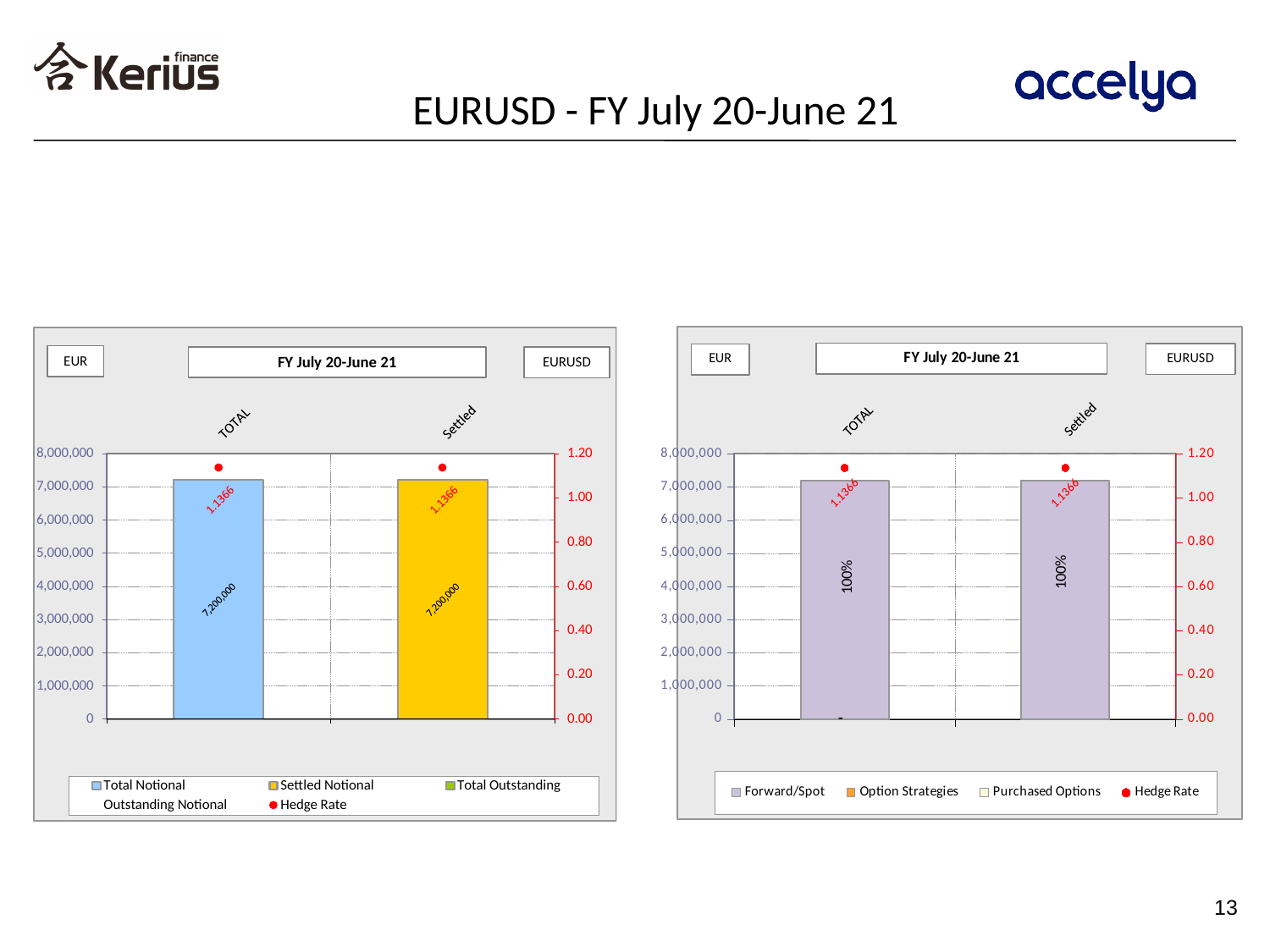
In the right chart, is the Hedge Rate for TOTAL greater or less than 1.00? greater In the right chart, what is the Hedge Rate shown for Settled? 1.1366 How many categories are shown on the x axis of the left chart? 2 In the left chart, is the value of the TOTAL bar greater or less than 6,000,000? greater How many series does the legend of the left chart list? 5 In the left chart, what is the value of the Settled bar? 7,200,000 In the left chart, what is the value of the TOTAL bar? 7,200,000 How many series does the legend of the right chart list? 4 In the left chart, what is the Hedge Rate shown for TOTAL? 1.1366 What type of chart is the left chart? Combination bar and line chart (bars with Hedge Rate points on a secondary axis) In the left chart, what is the difference between the TOTAL bar and the Settled bar? 0 In the right chart, what percentage label is shown on the TOTAL bar? 100%